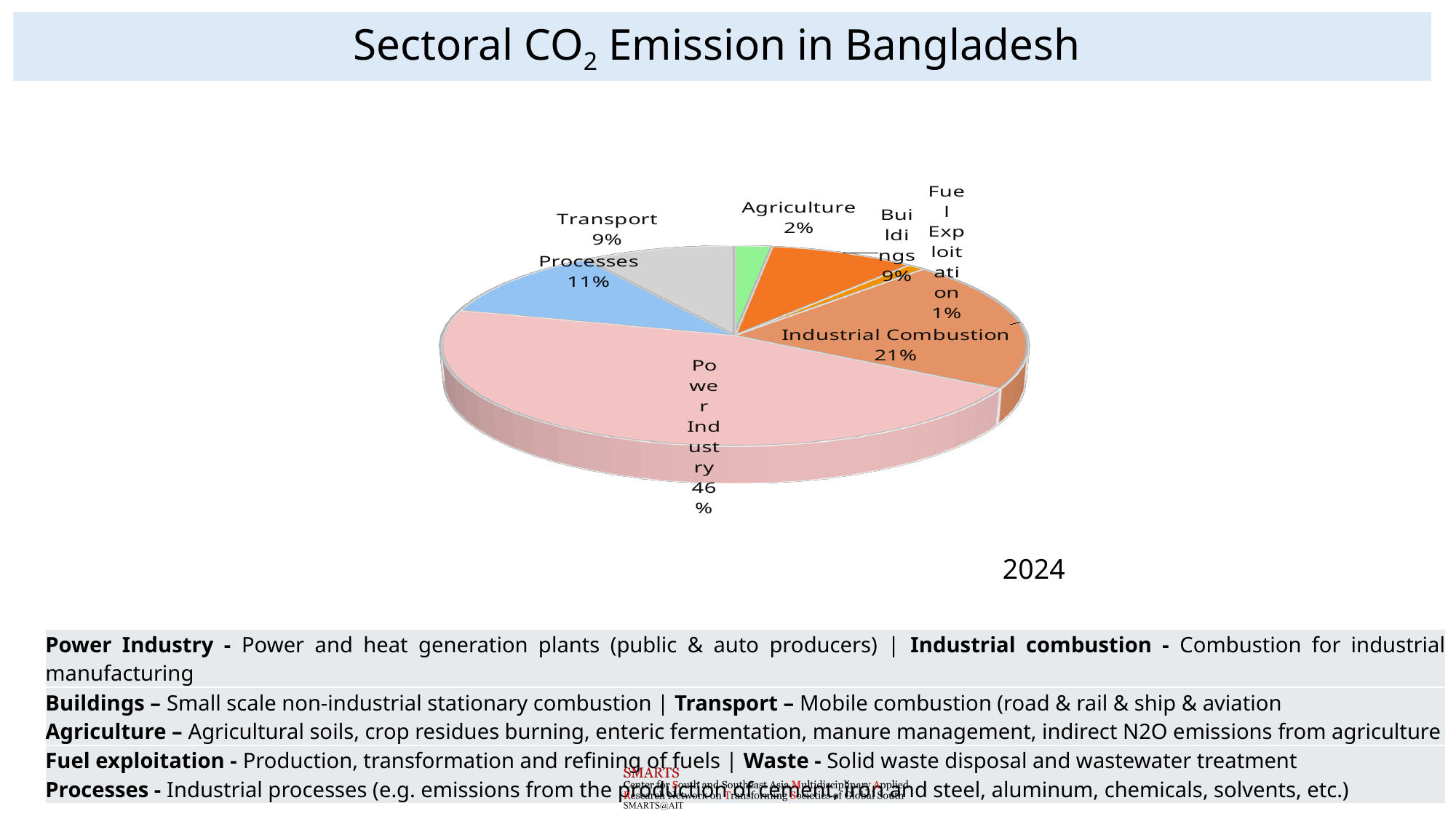
What is the percentage shown for Transport? 9% What is the percentage shown for Fuel Exploitation? 1% What share of CO2 emissions does Industrial Combustion account for? 21% What share of CO2 emissions does the Power Industry account for? 46% What is the percentage shown for Agriculture? 2% What kind of chart is shown on the slide? pie chart Which labelled sector has the smallest share of CO2 emissions? Fuel Exploitation What is the percentage shown for Processes? 11% Which has a larger share, Processes or Transport? Processes What year is shown below the chart? 2024 What is the difference in percentage points between Power Industry and Industrial Combustion? 25 Which sector has the largest share of CO2 emissions? Power Industry